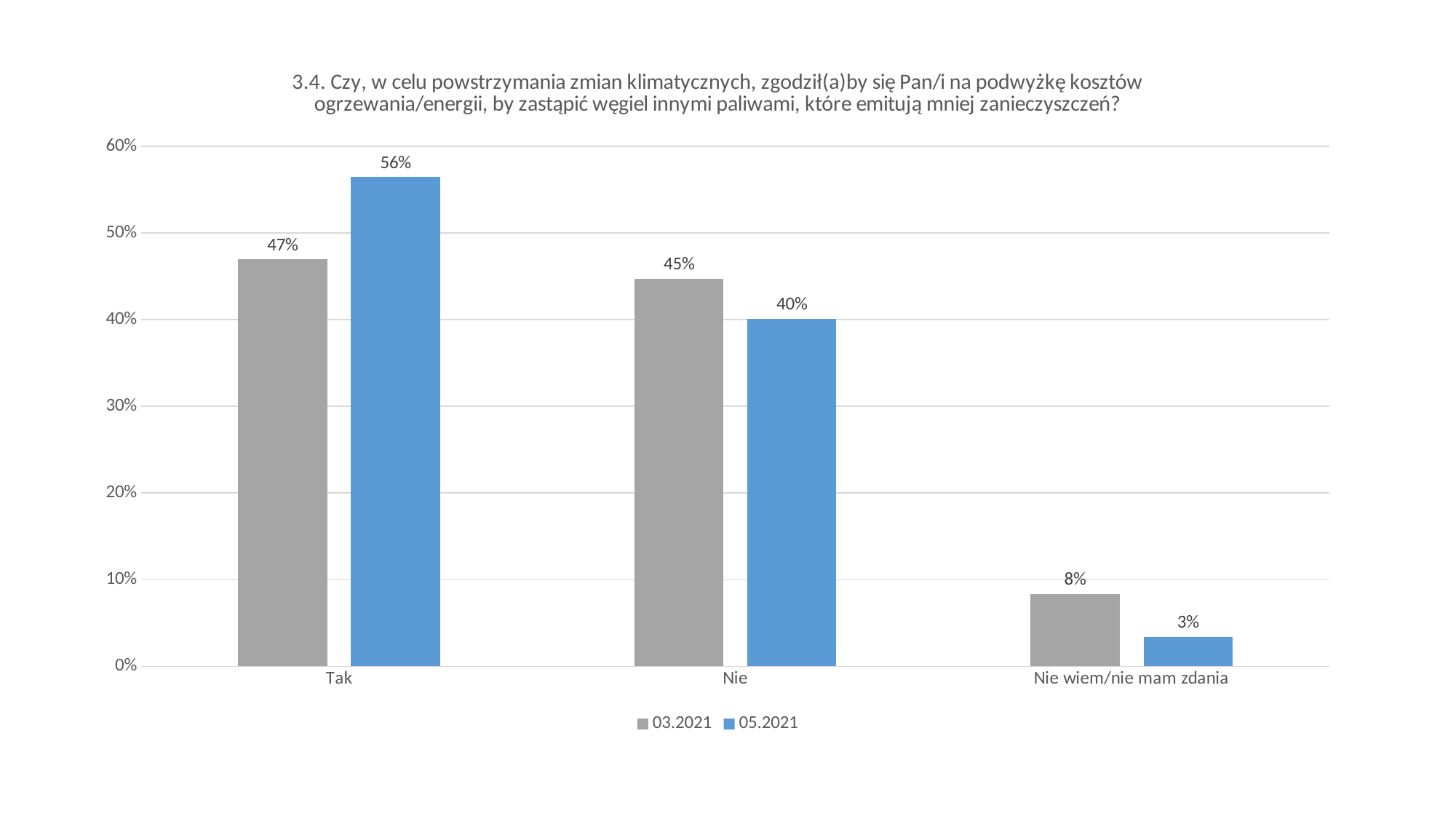
How many series does the legend list? 2 Is the 03.2021 value for "Tak" greater or less than 40%? greater Which category has the highest value in the 05.2021 series? Tak What is the value for "Tak" in the 05.2021 series? 56% What is the difference between the 05.2021 and 03.2021 values for "Tak"? 9% How many categories are shown on the x axis? 3 What is the value for "Nie" in the 03.2021 series? 45% What is the difference between the 03.2021 and 05.2021 values for "Nie"? 5% What kind of chart is shown on the slide? bar chart What is the value for "Nie wiem/nie mam zdania" in the 05.2021 series? 3% Which category has the lowest value in the 03.2021 series? Nie wiem/nie mam zdania Which is larger for "Nie": the 03.2021 value or the 05.2021 value? 03.2021